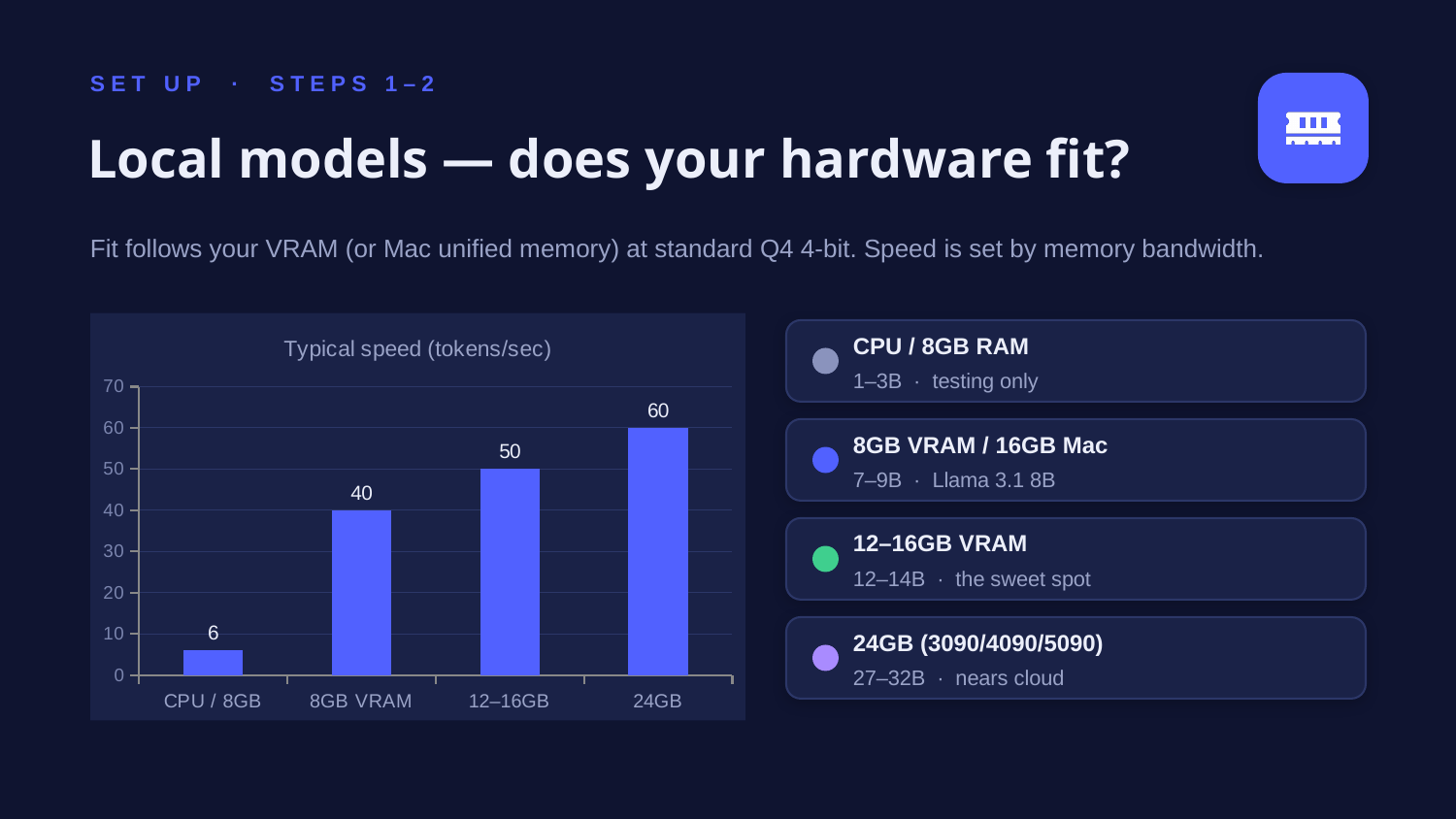
Do the values rise or fall from left to right along the x axis? Rise What kind of chart is shown on the slide? Bar chart How many categories are shown on the chart? 4 What is the typical speed in tokens/sec for CPU / 8GB? 6 What is the typical speed in tokens/sec for 24GB? 60 What is the typical speed in tokens/sec for 8GB VRAM? 40 Which category has the lowest typical speed? CPU / 8GB What is the title of the chart? Typical speed (tokens/sec) What is the difference in typical speed between 24GB and 8GB VRAM? 20 Which has a higher typical speed, 12–16GB or 8GB VRAM? 12–16GB Which category has the highest typical speed? 24GB What is the typical speed in tokens/sec for 12–16GB? 50